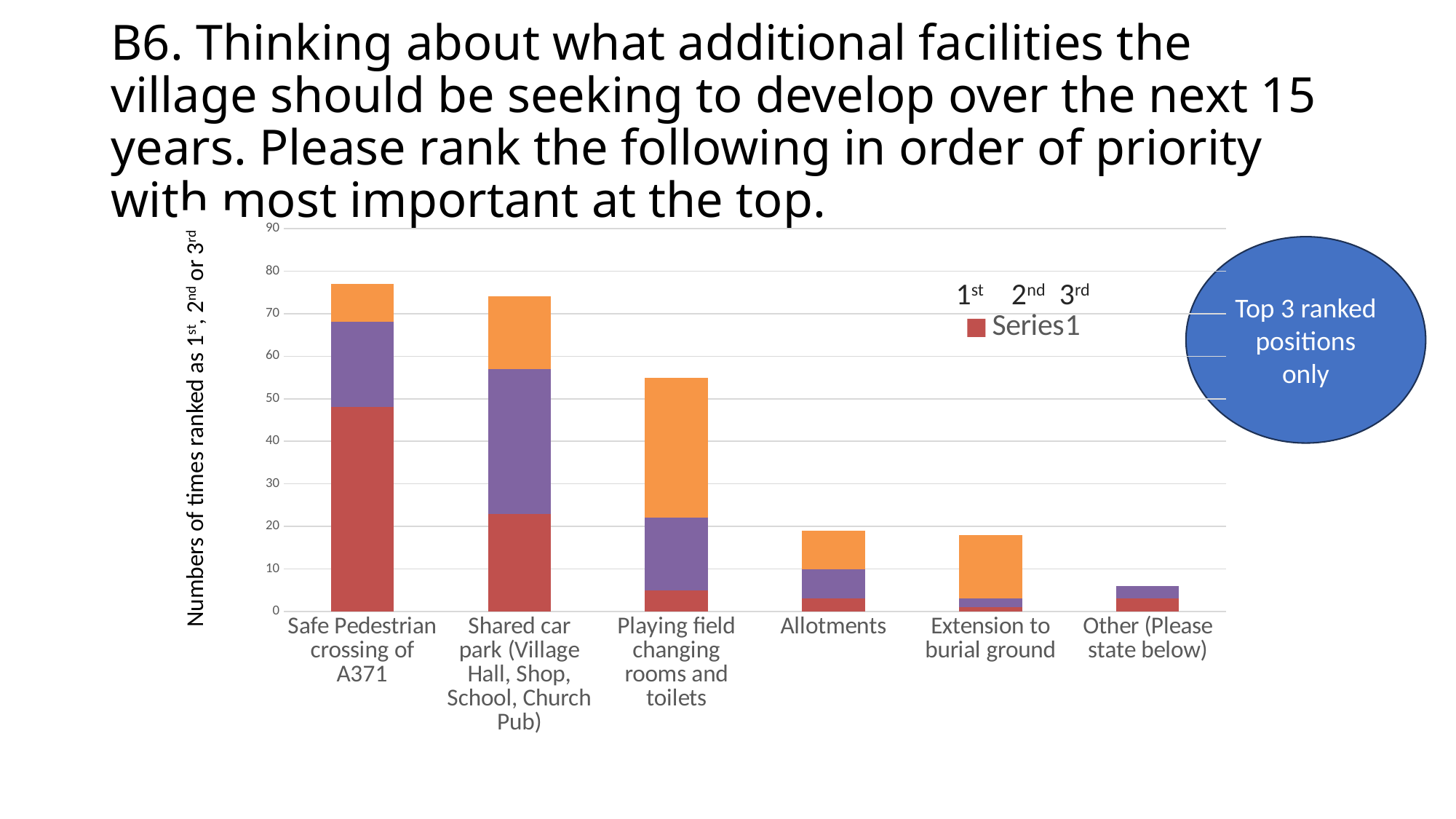
What colour is the bottom segment of each stacked bar? red Which category has the shortest bar in the chart? Other (Please state below) What is the title of the vertical axis of the chart? Numbers of times ranked as 1st, 2nd or 3rd How many categories are shown on the x axis of the chart? 6 Is the total bar height for Playing field changing rooms and toilets greater or less than 50? greater Do the bar totals generally rise or fall moving from left to right along the x axis? fall What kind of chart is shown on the slide? stacked bar chart Which has the taller bar: Playing field changing rooms and toilets or Allotments? Playing field changing rooms and toilets Is the total bar height for Safe Pedestrian crossing of A371 greater or less than 70? greater Is the total bar height for Other (Please state below) greater or less than 10? less Which category has the tallest bar in the chart? Safe Pedestrian crossing of A371